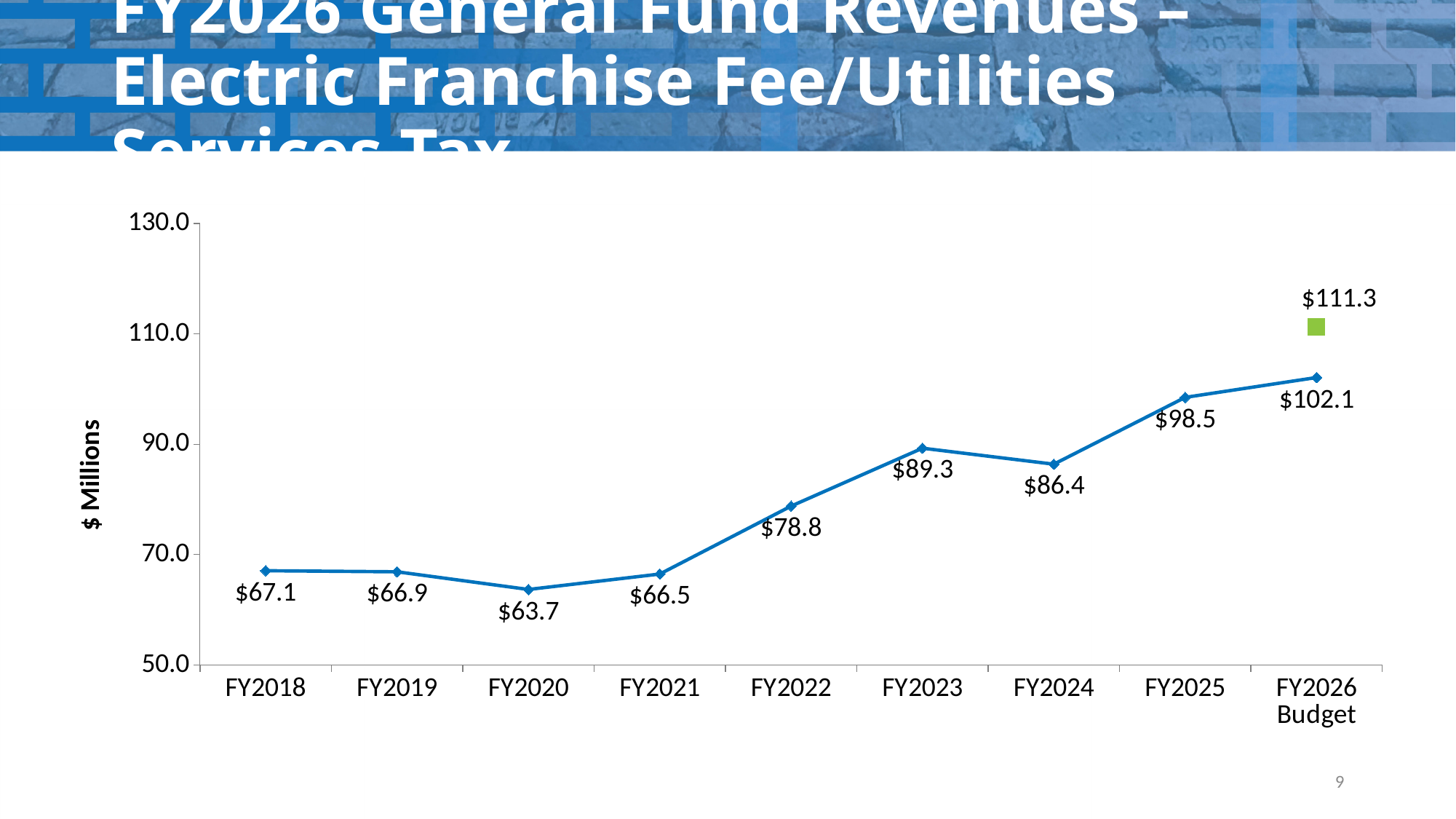
What kind of chart is shown on the slide? line chart Which fiscal year has the lowest value on the line? FY2020 What is the difference between the FY2025 value and the FY2024 value? $12.1 Do the values on the line generally rise or fall from FY2021 to FY2026 Budget? rise Which fiscal year has the highest value on the blue line? FY2026 Budget What value is shown by the green square marker above the FY2026 Budget point? $111.3 Is the value for FY2021 greater or less than 70.0? less What is the label on the vertical axis? $ Millions What is the value for FY2020? $63.7 Which is larger, the value for FY2023 or the value for FY2024? FY2023 How many fiscal years are plotted along the x axis? 9 What is the value for FY2022 on the line? $78.8